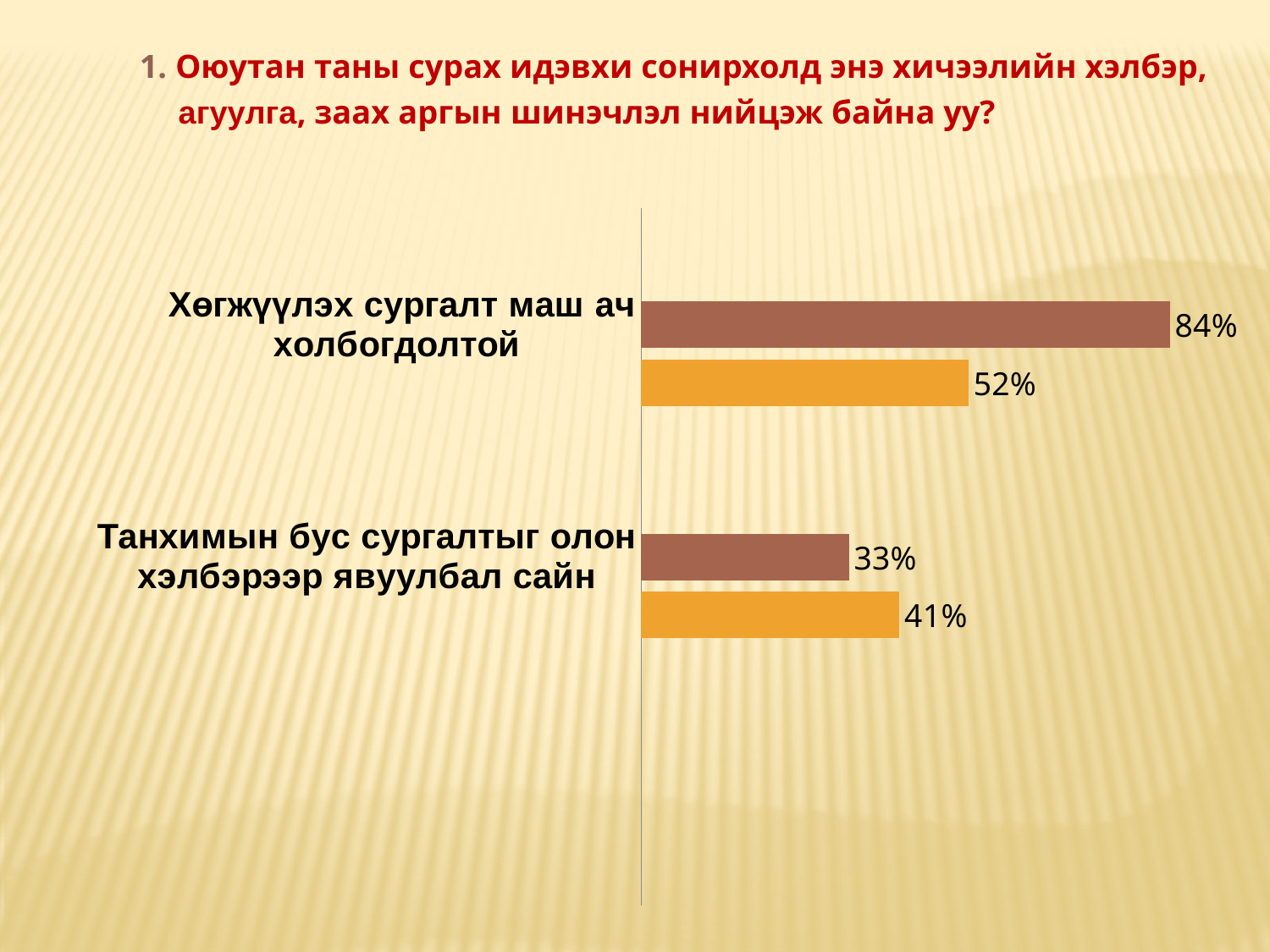
Which bar has the highest value in the chart? the brown bar for "Хөгжүүлэх сургалт маш ач холбогдолтой" (84%) Which bar has the lowest value in the chart? the brown bar for "Танхимын бус сургалтыг олон хэлбэрээр явуулбал сайн" (33%) What is the value of the orange bar for "Танхимын бус сургалтыг олон хэлбэрээр явуулбал сайн"? 41% For "Танхимын бус сургалтыг олон хэлбэрээр явуулбал сайн", which bar is larger, the brown or the orange one? orange How many bars are shown for each category? 2 What is the value of the brown bar for "Хөгжүүлэх сургалт маш ач холбогдолтой"? 84% What type of chart is shown on the slide? bar chart What is the difference between the brown and orange bars for "Хөгжүүлэх сургалт маш ач холбогдолтой"? 32% How many categories are shown on the chart? 2 What is the value of the brown bar for "Танхимын бус сургалтыг олон хэлбэрээр явуулбал сайн"? 33% What is the value of the orange bar for "Хөгжүүлэх сургалт маш ач холбогдолтой"? 52% What is the difference between the orange and brown bars for "Танхимын бус сургалтыг олон хэлбэрээр явуулбал сайн"? 8%